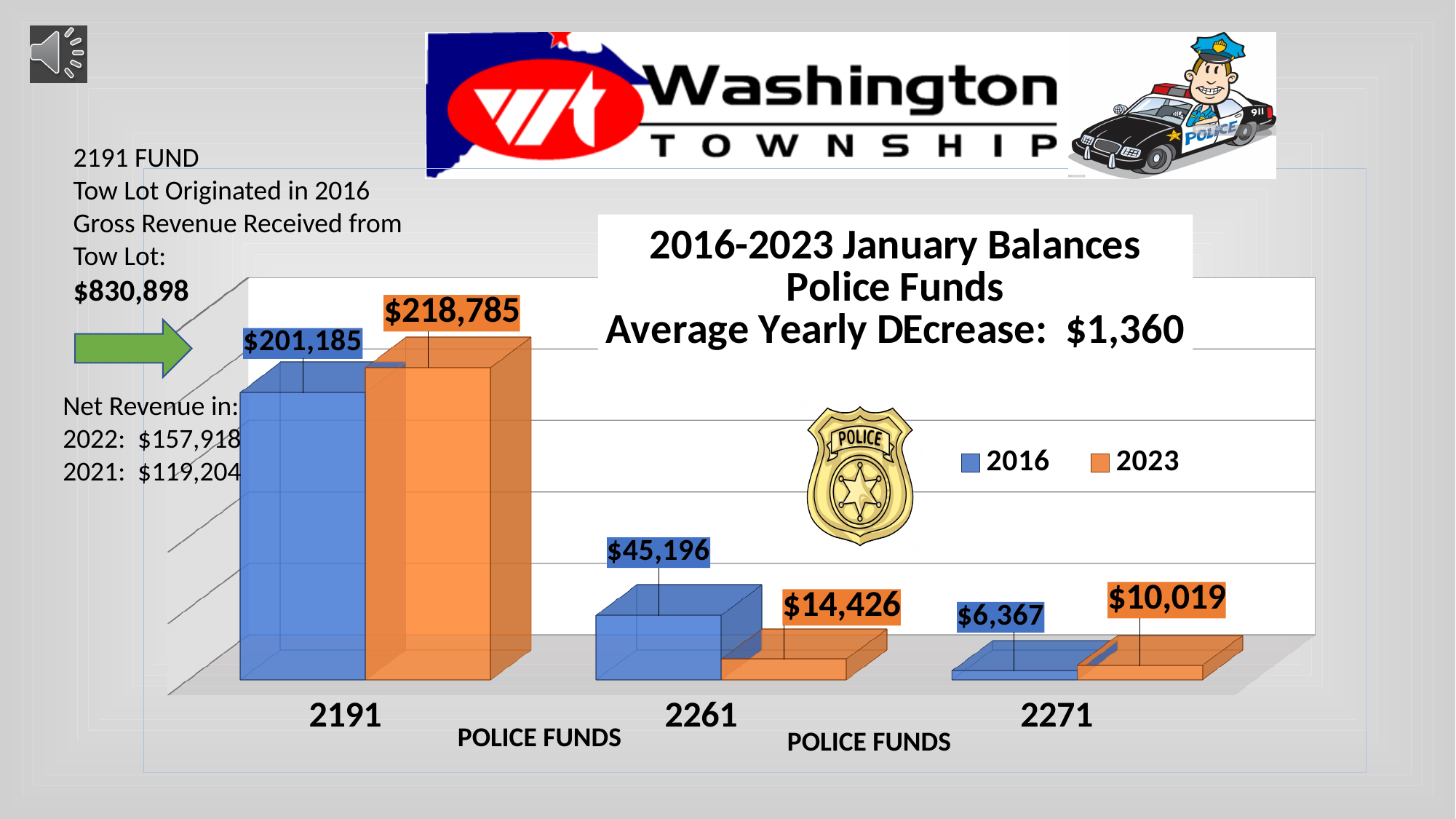
How many series does the legend list? 2 How many funds are shown on the x axis? 3 What is the difference between the 2016 and 2023 values for fund 2261? $30,770 What is the 2016 value for fund 2271? $6,367 What is the 2023 value for fund 2191? $218,785 What kind of chart is shown on the slide? Bar chart What is the 2023 value for fund 2261? $14,426 Which fund has the lowest 2016 balance? 2271 Which fund has the highest 2023 balance? 2191 For fund 2271, which is larger: the 2016 value or the 2023 value? 2023 What is the difference between the 2023 and 2016 values for fund 2191? $17,600 What is the 2016 value for fund 2191? $201,185